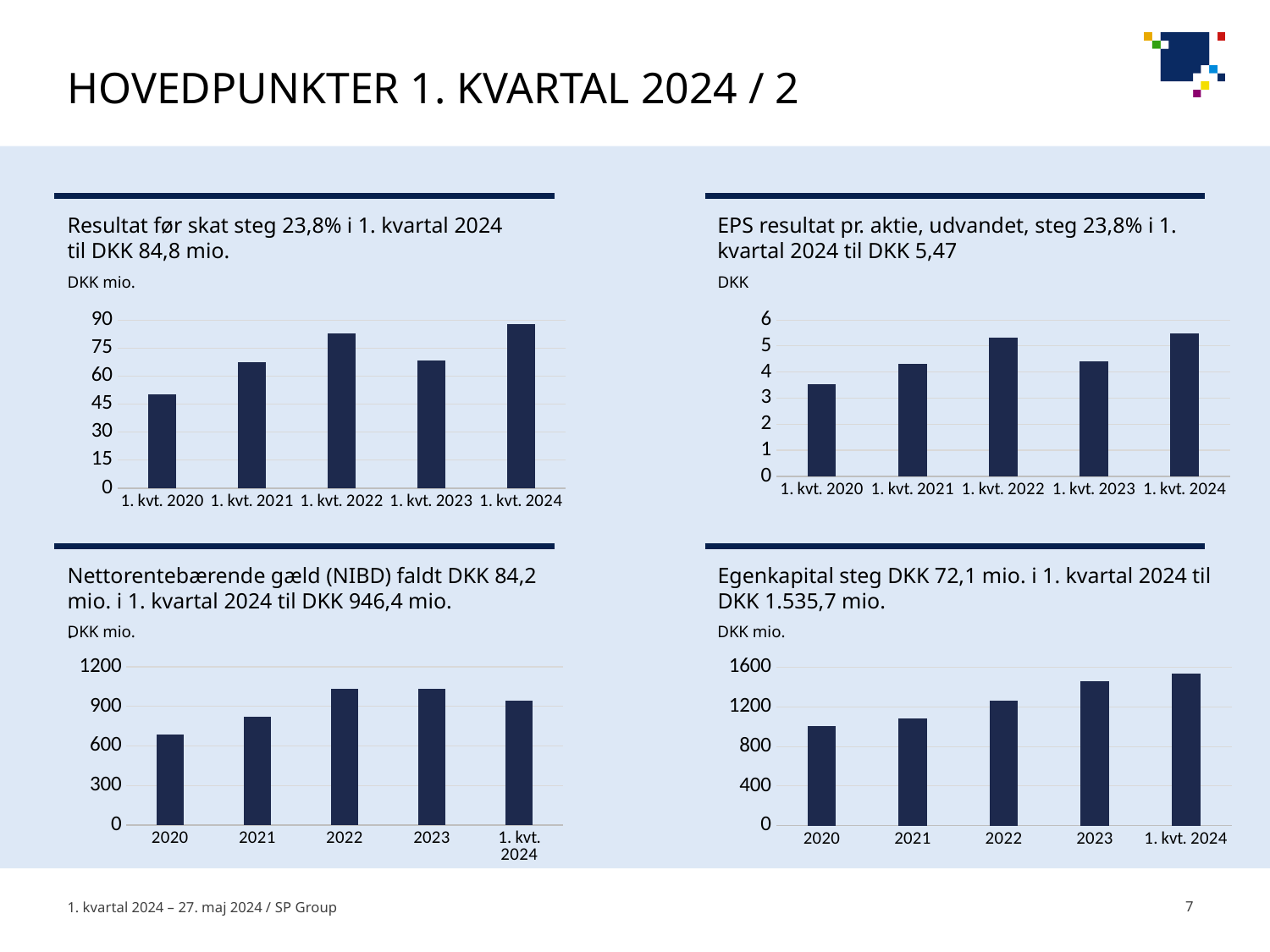
In the top-left chart (Resultat før skat), which quarter has the highest bar? 1. kvt. 2024 In the bottom-right chart (Egenkapital), is the value for 2020 greater or less than 1200? less In the top-left chart (Resultat før skat), is the value for 1. kvt. 2020 greater or less than 60? less In the bottom-left chart (Nettorentebærende gæld), is the value for 2022 greater or less than 900? greater In the top-right chart (EPS resultat pr. aktie), what unit is shown above the chart? DKK In the bottom-left chart (Nettorentebærende gæld), which category has the lowest bar? 2020 In the top-left chart (Resultat før skat), how many quarters are plotted? 5 What kind of chart is the top-left chart titled 'Resultat før skat steg 23,8% i 1. kvartal 2024 til DKK 84,8 mio.'? Bar chart In the top-left chart (Resultat før skat), which quarter has the lowest bar? 1. kvt. 2020 In the bottom-right chart (Egenkapital), do the values rise or fall from 2020 to 1. kvt. 2024? rise In the top-right chart (EPS resultat pr. aktie), which is larger, the value for 1. kvt. 2022 or 1. kvt. 2023? 1. kvt. 2022